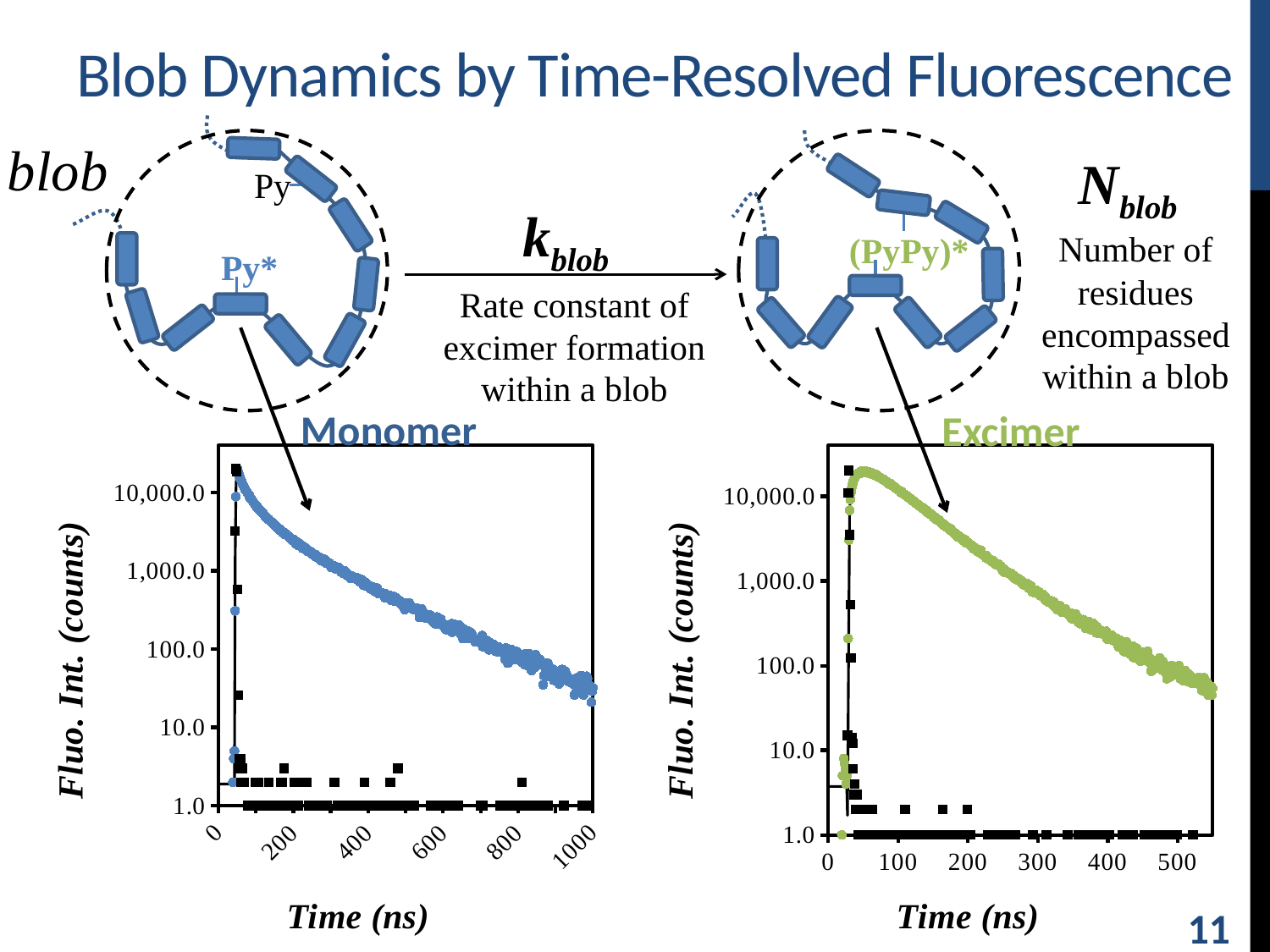
What kind of chart is the Excimer chart on the right? scatter chart How many charts are shown on the slide? 2 What is the x-axis label of the Excimer chart? Time (ns) In the Excimer chart, does the green fluorescence intensity rise or fall as time increases beyond its peak? fall In the Excimer chart, is the peak green fluorescence intensity greater or less than 10,000.0 counts? greater In the Monomer chart, is the blue fluorescence intensity at 200 ns greater or less than 1,000.0 counts? greater In the Monomer chart, is the blue fluorescence intensity at 1000 ns greater or less than 100.0 counts? less In the Monomer chart, does the blue fluorescence intensity rise or fall as time increases beyond its peak? fall What kind of chart is the Monomer chart on the left? scatter chart What is the y-axis label of the Monomer chart? Fluo. Int. (counts)